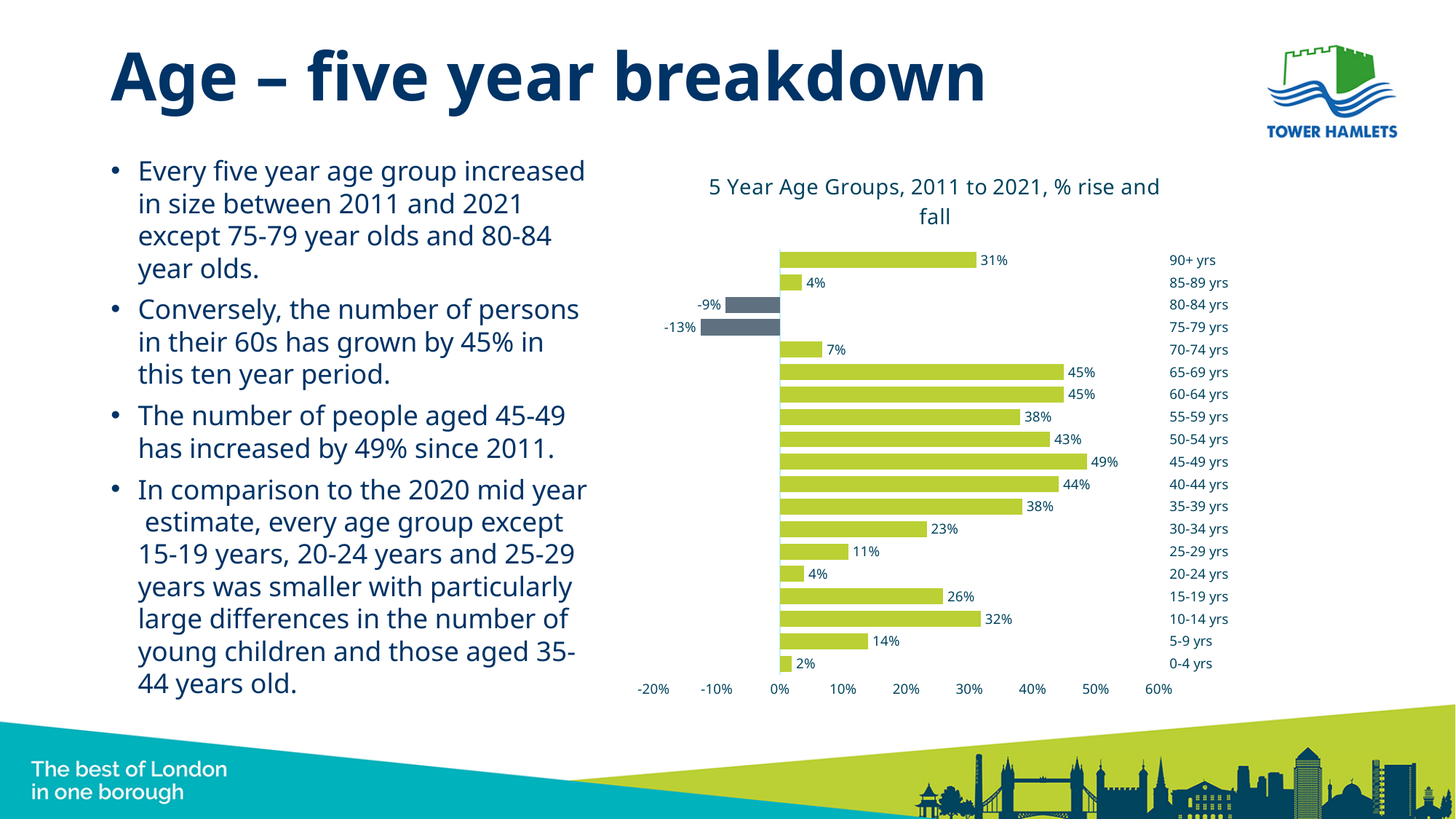
Is the value for 55-59 yrs greater or less than 30%? greater Which age group has the highest percentage rise? 45-49 yrs What is the percentage change shown for the 0-4 yrs age group? 2% What is the percentage change shown for the 75-79 yrs age group? -13% What is the difference between the values for 10-14 yrs and 5-9 yrs? 18 percentage points Which age group has the lowest value on the chart? 75-79 yrs What is the percentage change shown for the 90+ yrs age group? 31% What is the percentage change shown for the 45-49 yrs age group? 49% What is the title of the chart? 5 Year Age Groups, 2011 to 2021, % rise and fall What kind of chart is shown on the slide? Bar chart Which has the larger value, 30-34 yrs or 25-29 yrs? 30-34 yrs How many age groups are plotted on the chart? 19